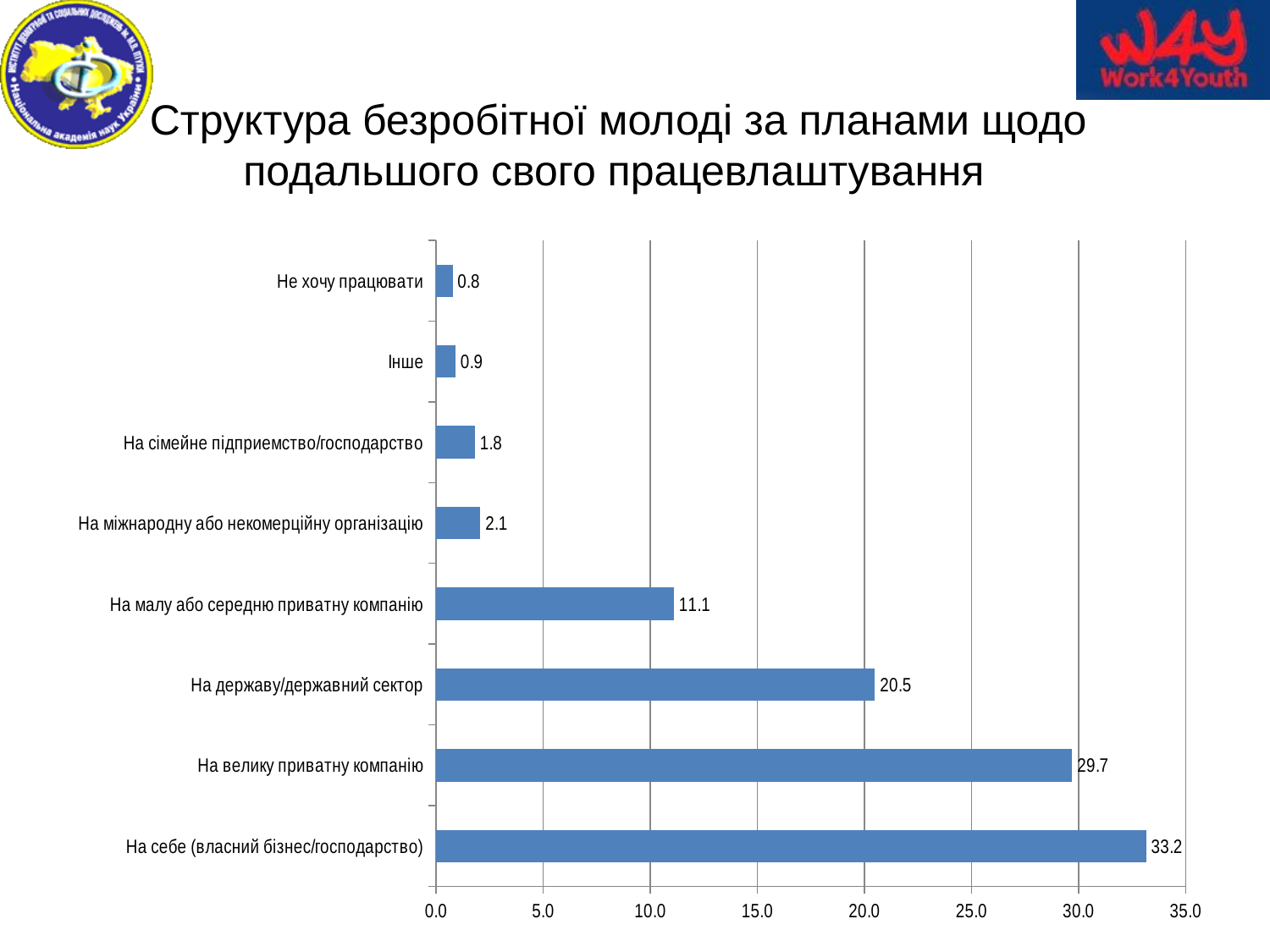
What is the value for "На міжнародну або некомерційну організацію"? 2.1 What kind of chart is shown on the slide? bar chart What is the value for "На себе (власний бізнес/господарство)"? 33.2 Which is larger: the value for "На державу/державний сектор" or "На малу або середню приватну компанію"? На державу/державний сектор What is the value for "На державу/державний сектор"? 20.5 Which category has the highest value? На себе (власний бізнес/господарство) How many categories are shown in the chart? 8 Which category has the lowest value? Не хочу працювати What is the value for "На малу або середню приватну компанію"? 11.1 Is the value for "На велику приватну компанію" greater or less than 25.0? greater What is the difference between the values for "На себе (власний бізнес/господарство)" and "На велику приватну компанію"? 3.5 What is the maximum value shown on the horizontal axis? 35.0